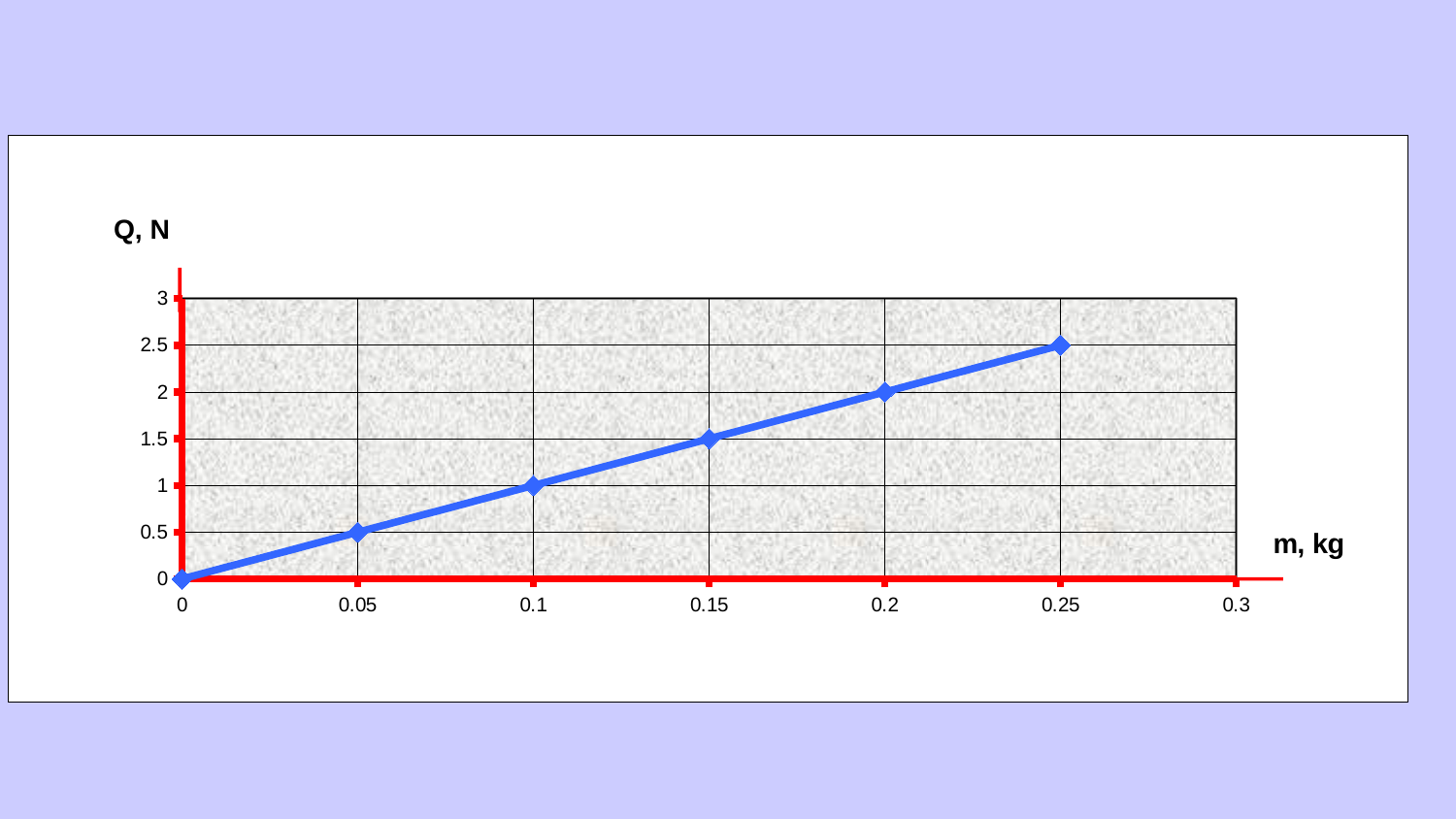
Do the values of Q rise or fall as m increases along the x axis? rise What kind of chart is shown on the slide? line chart What is the label of the vertical axis? Q, N At which value of m is Q lowest? 0 What is the value of Q when m is 0.2 kg? 2 What is the value of Q when m is 0.25 kg? 2.5 At which value of m is Q highest? 0.25 How many data points are plotted on the line? 6 What is the value of Q when m is 0.05 kg? 0.5 What is the value of Q when m is 0.1 kg? 1 Which is larger: Q at m = 0.15 kg or Q at m = 0.05 kg? Q at m = 0.15 kg What is the difference between Q at m = 0.2 kg and Q at m = 0.1 kg? 1